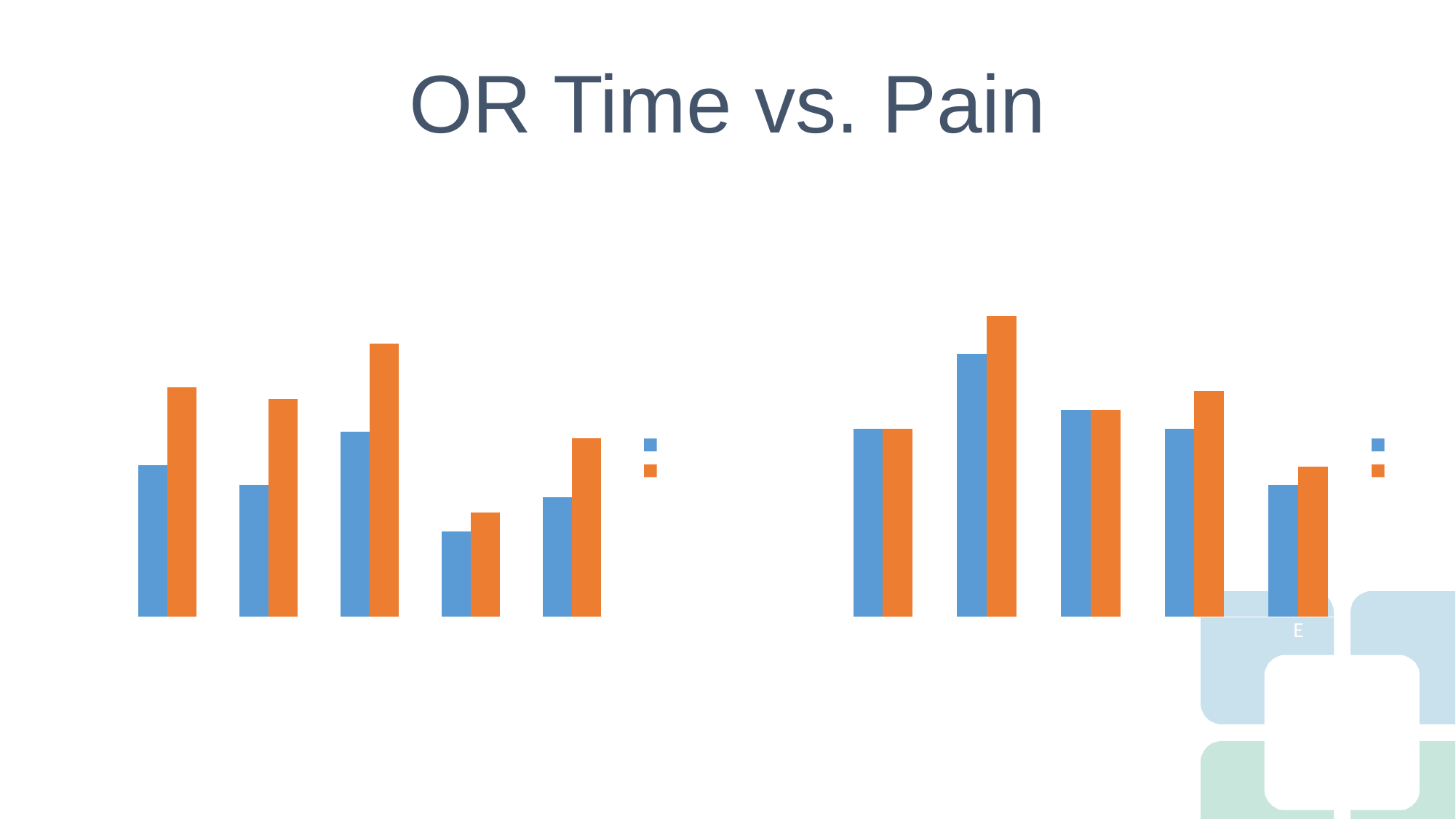
In the left chart, in the first group from the left, is the blue bar or the orange bar taller? The orange bar How many series does the legend of the left chart list? 2 In the right chart, which group from the left has the shortest orange bar? The fifth group What kind of chart is the chart on the right side of the slide? Bar chart How many groups of bars does the left chart show? 5 What kind of chart is the chart on the left side of the slide? Bar chart In the left chart, which group from the left has the shortest blue bar? The fourth group In the left chart, which group from the left has the tallest orange bar? The third group What colours are the two series in the charts? Blue and orange How many groups of bars does the right chart show? 5 How many series does the legend of the right chart list? 2 In the right chart, which group from the left has the tallest blue bar? The second group